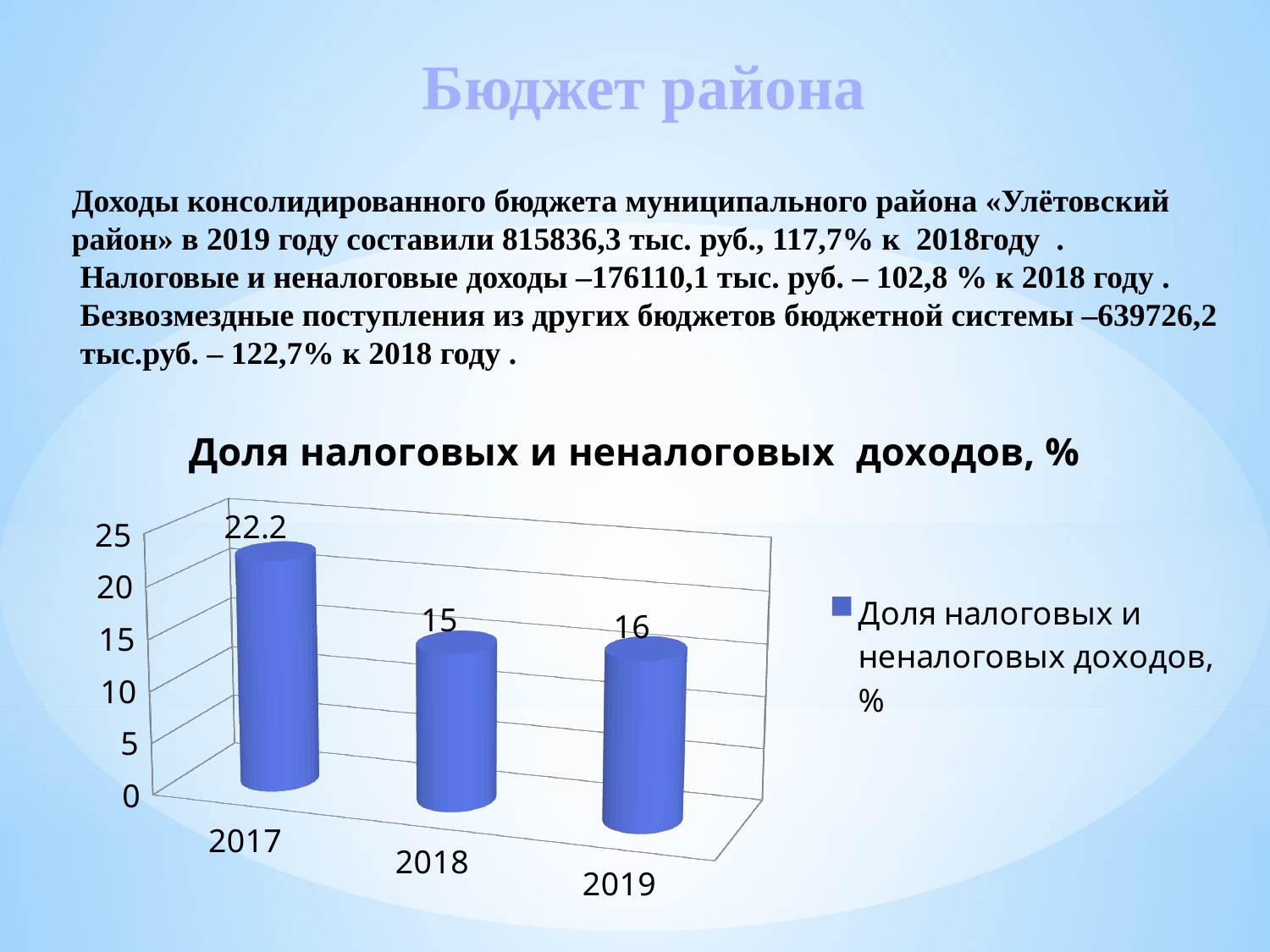
What is the difference between the values for 2017 and 2018? 7.2 What is the value for 2018 in the chart? 15 Which year has the lowest value in the chart? 2018 Which is larger, the value for 2017 or the value for 2019? 2017 Which year has the highest value in the chart? 2017 How many years are shown in the chart? 3 Is the value for 2017 greater or less than 20? greater What is the difference between the values for 2019 and 2018? 1 What is the value for 2019 in the chart? 16 What kind of chart is shown on the slide? bar chart What is the value for 2017 in the chart? 22.2 What is the title of the chart? Доля налоговых и неналоговых доходов, %